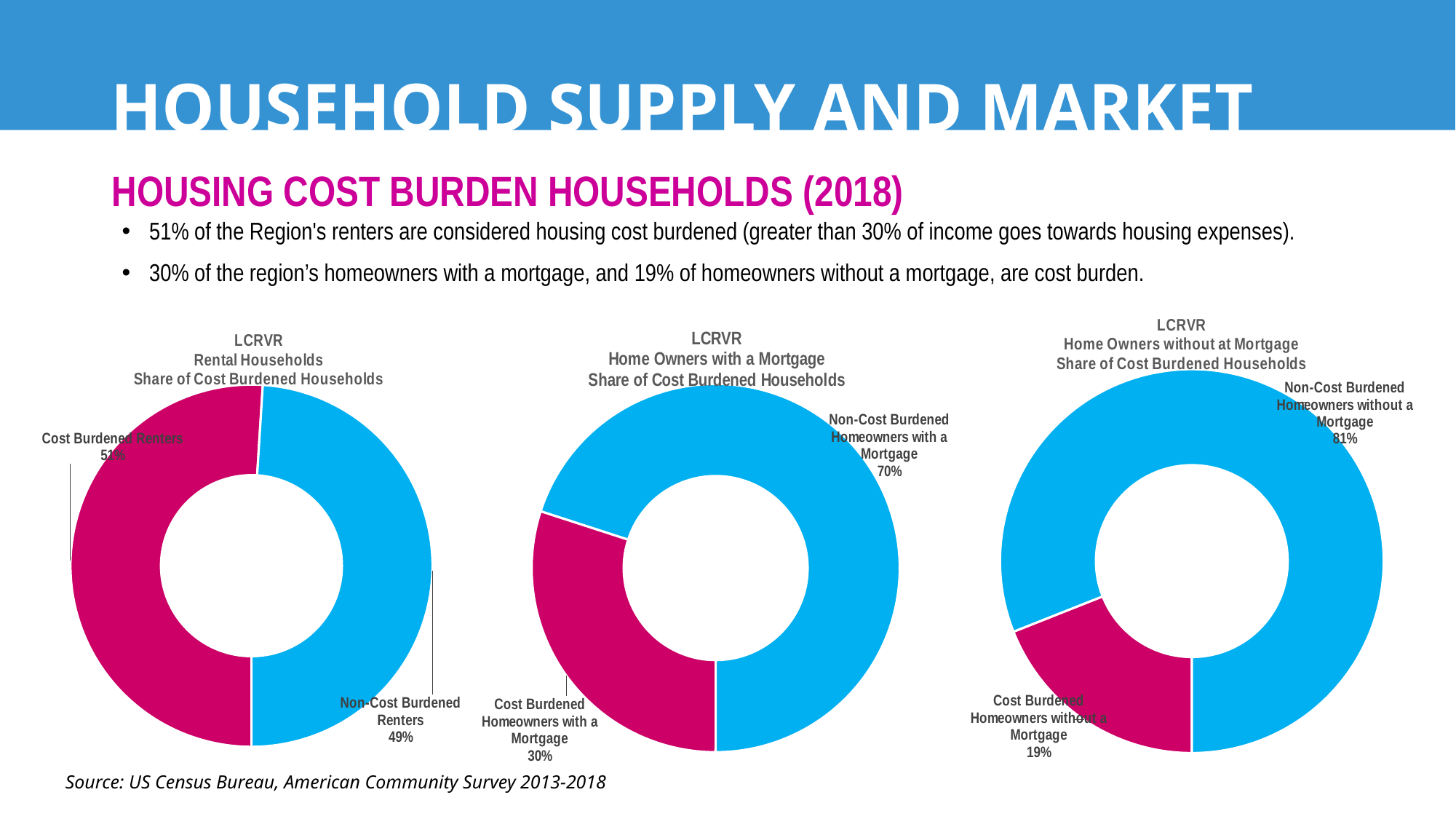
In the left chart (LCRVR Rental Households), what share of renters are non-cost burdened? 49% In the middle chart (Home Owners with a Mortgage), what share of homeowners with a mortgage are cost burdened? 30% Is the cost burdened share in the left chart (Rental Households) larger or smaller than the cost burdened share in the right chart (Home Owners without a Mortgage)? larger How many slices does each donut chart on the slide have? 2 In the left chart (LCRVR Rental Households), what share of renters are cost burdened? 51% In the right chart (Home Owners without a Mortgage), which slice is the smallest? Cost Burdened Homeowners without a Mortgage In the right chart (Home Owners without a Mortgage), what share of homeowners without a mortgage are non-cost burdened? 81% In the middle chart (Home Owners with a Mortgage), what is the difference in percentage points between the non-cost burdened and cost burdened slices? 40 In the middle chart (Home Owners with a Mortgage), what share of homeowners with a mortgage are non-cost burdened? 70% What type of chart is used for the three charts on the slide? Donut (pie) chart In the right chart (Home Owners without a Mortgage), what share of homeowners without a mortgage are cost burdened? 19% In the middle chart (Home Owners with a Mortgage), which slice is larger: cost burdened or non-cost burdened homeowners? Non-Cost Burdened Homeowners with a Mortgage